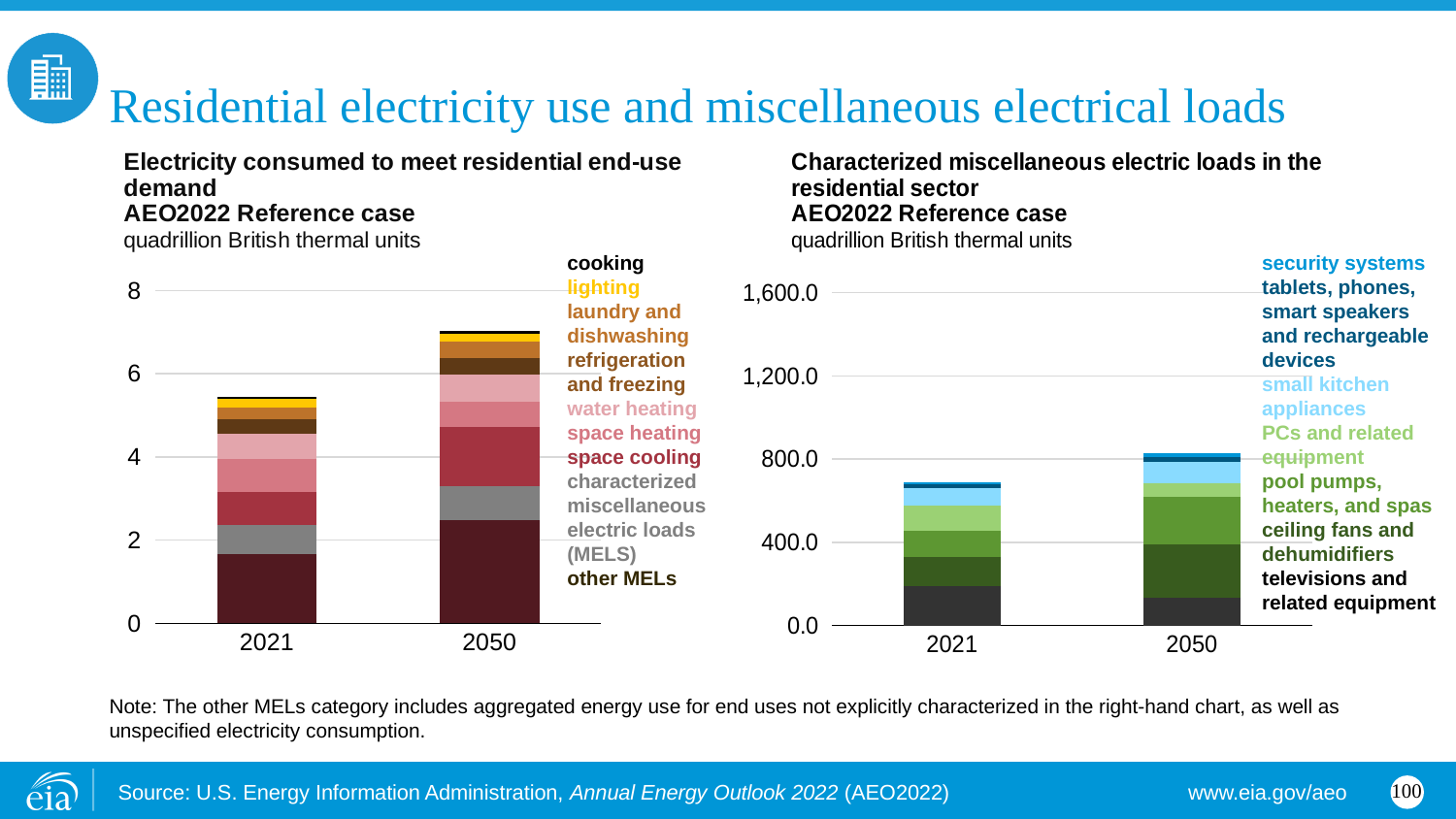
In the right chart, 'Characterized miscellaneous electric loads in the residential sector', how many series does the legend list? 7 In the left chart, 'Electricity consumed to meet residential end-use demand', is the total for 2021 greater or less than 6? less In the left chart, 'Electricity consumed to meet residential end-use demand', how many years are shown on the x axis? 2 In the left chart, 'Electricity consumed to meet residential end-use demand', is the total for 2050 greater or less than 6? greater In the right chart, 'Characterized miscellaneous electric loads in the residential sector', is the total for 2021 greater or less than 800.0? less What type of chart is the left chart, 'Electricity consumed to meet residential end-use demand'? stacked bar chart In the right chart, 'Characterized miscellaneous electric loads in the residential sector', does the total rise or fall from 2021 to 2050? rise In the right chart, 'Characterized miscellaneous electric loads in the residential sector', which legend entry is listed last? televisions and related equipment In the left chart, 'Electricity consumed to meet residential end-use demand', how many series does the legend list? 9 In the left chart, 'Electricity consumed to meet residential end-use demand', what unit is used on the y axis? quadrillion British thermal units In the left chart, 'Electricity consumed to meet residential end-use demand', which year has the taller stacked bar, 2021 or 2050? 2050